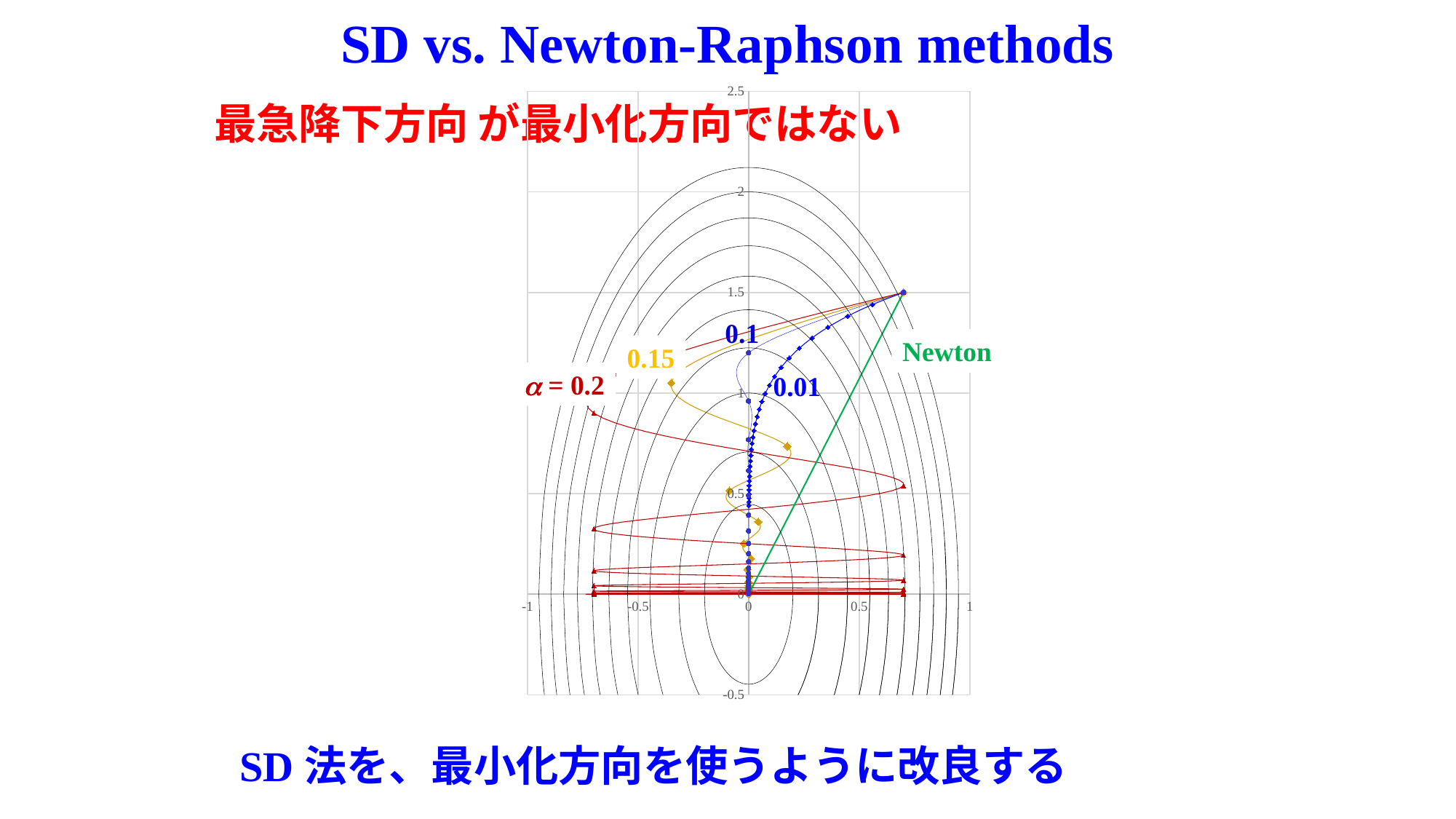
Which labeled path reaches the minimum at the origin in a single straight step? Newton Is the starting x-value of the paths greater or less than 0.5? greater What is the lowest value shown on the vertical axis? -0.5 What is the title of the chart slide? SD vs. Newton-Raphson methods How many labeled optimization paths are drawn on the chart? 5 Is the starting y-value of the paths greater or less than 1? greater Which step-size label is attached to the red zig-zag path? α = 0.2 What is the highest value shown on the vertical axis? 2.5 What kind of chart is shown on the slide? line chart (optimization paths over contour lines) What colour is the path labeled "Newton"? green Which step-size value is labeled on the orange path? 0.15 What is the leftmost value shown on the horizontal axis? -1